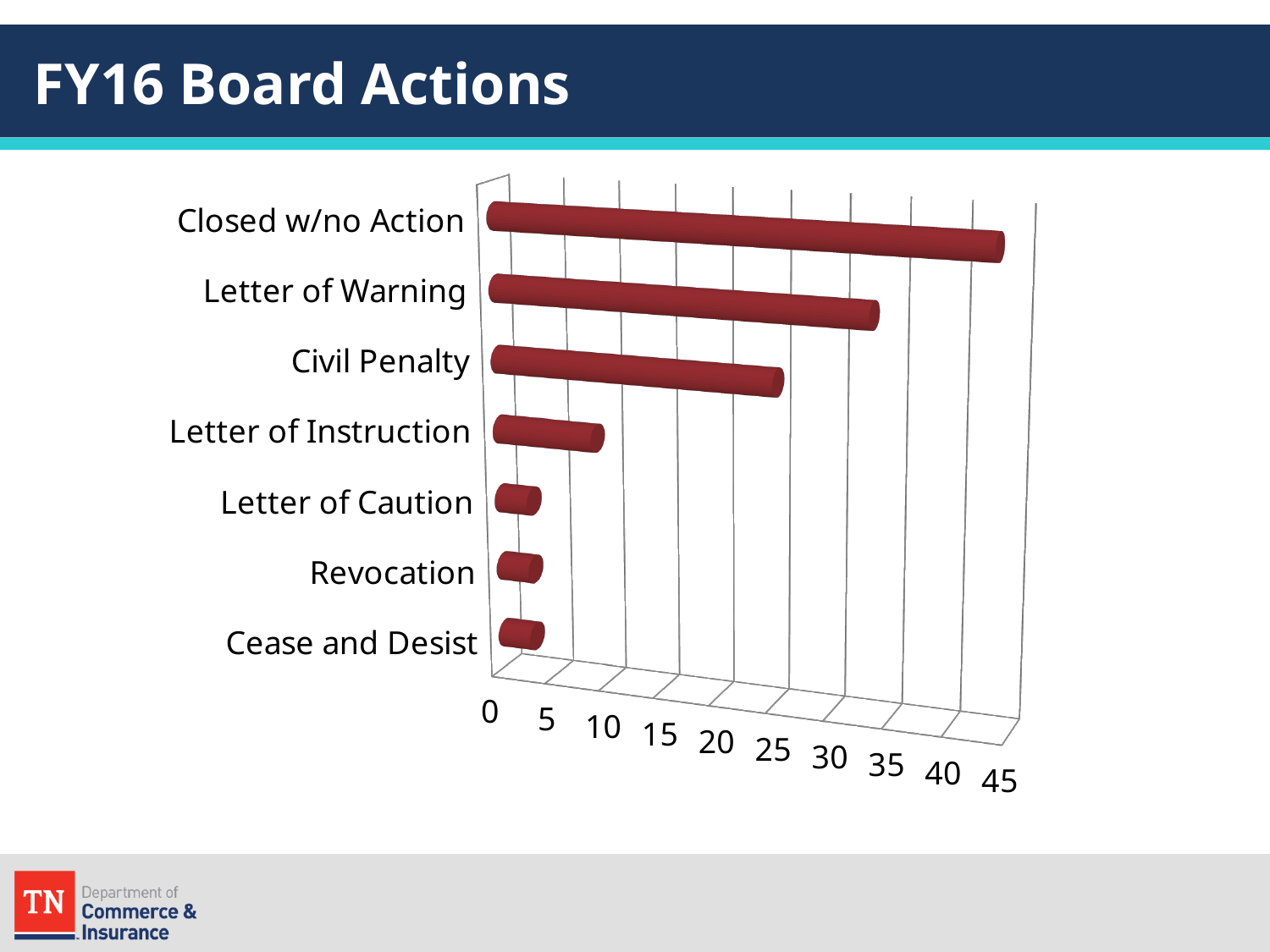
Is the value for Letter of Warning greater or less than 25? greater Which category has the highest value? Closed w/no Action Is the value for Letter of Instruction greater or less than 5? greater What kind of chart is shown on the slide? bar chart Which is larger, the value for Letter of Warning or the value for Civil Penalty? Letter of Warning Is the value for Letter of Caution greater or less than 5? less Which is larger, the value for Civil Penalty or the value for Letter of Instruction? Civil Penalty How many categories are plotted in the chart? 7 What is the title of the chart on the slide? FY16 Board Actions